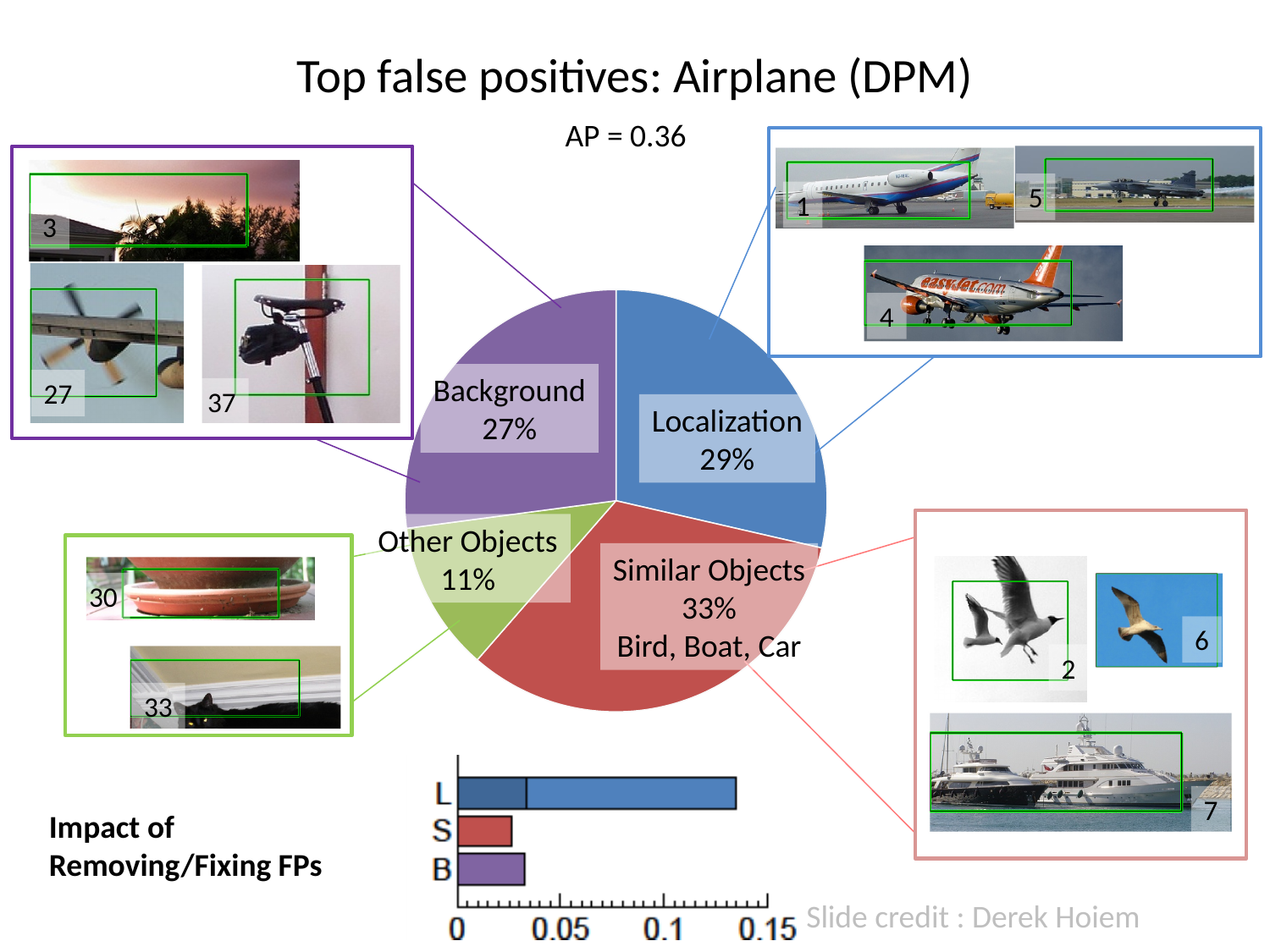
In the pie chart, what share of top false positives is attributed to Similar Objects? 33% In the 'Impact of Removing/Fixing FPs' bar chart, which bar is the longest? L How many slices does the pie chart have? 4 In the pie chart, how many percentage points larger is the Similar Objects share than the Other Objects share? 22 In the pie chart, what share of top false positives is attributed to Background? 27% In the 'Impact of Removing/Fixing FPs' bar chart, is the value for L greater or less than 0.1? greater In the pie chart, which category has the smallest share? Other Objects In the pie chart, what share of top false positives is attributed to Other Objects? 11% In the pie chart, which is larger: the Localization share or the Background share? Localization In the pie chart, what share of top false positives is attributed to Localization? 29% What kind of chart is the 'Impact of Removing/Fixing FPs' chart at the bottom of the slide? bar chart In the pie chart, which category has the largest share? Similar Objects